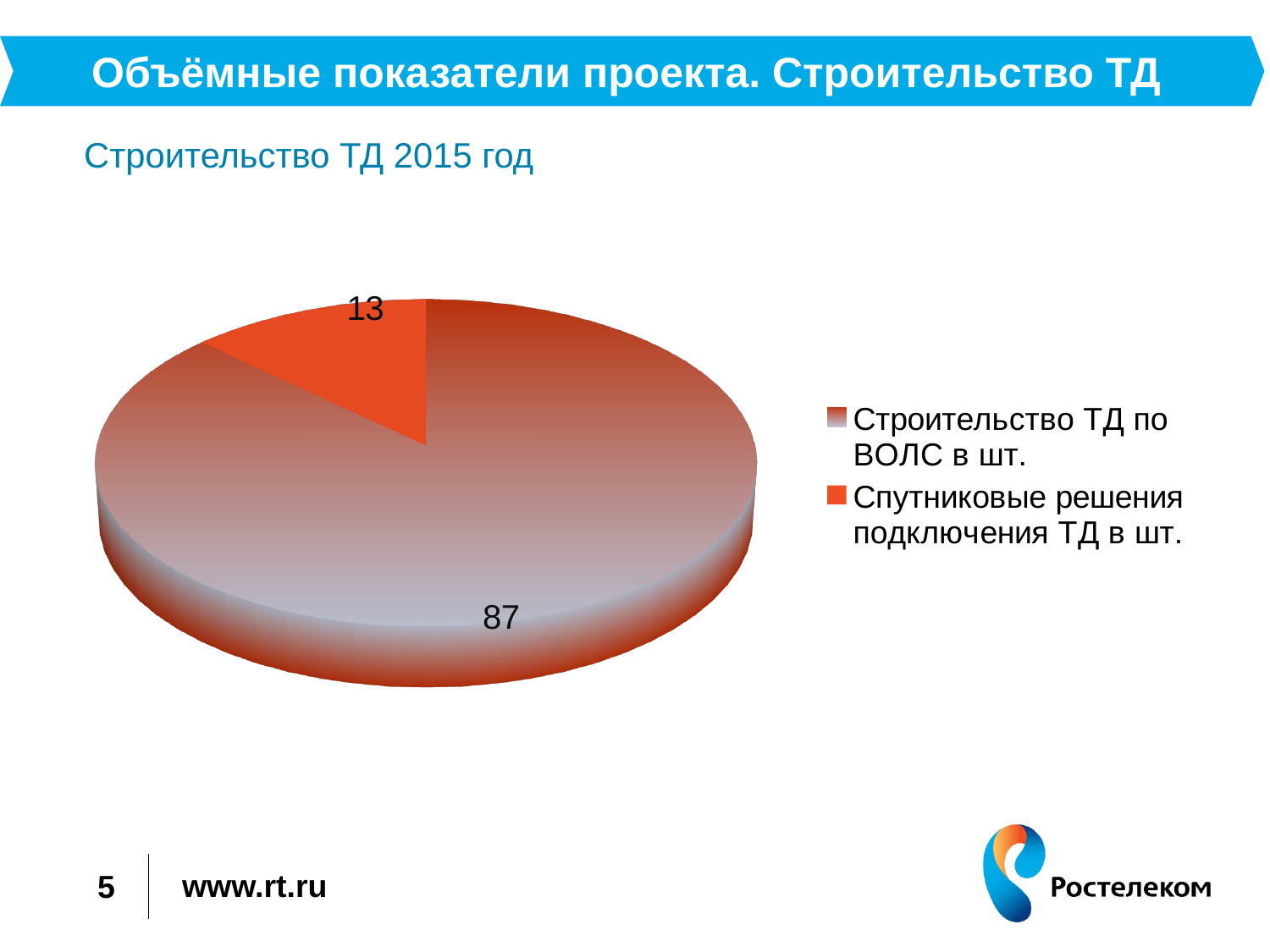
Which category has the smallest slice of the pie? Спутниковые решения подключения ТД в шт. What share of the pie does "Спутниковые решения подключения ТД в шт." represent? 13% What is the total of the two values shown on the pie chart? 100 What is the value for "Строительство ТД по ВОЛС в шт."? 87 How many entries does the legend list? 2 Which is larger: the value for "Строительство ТД по ВОЛС в шт." or for "Спутниковые решения подключения ТД в шт."? Строительство ТД по ВОЛС в шт. What is the difference between the values for "Строительство ТД по ВОЛС в шт." and "Спутниковые решения подключения ТД в шт."? 74 What is the title of the chart? Строительство ТД 2015 год What kind of chart is shown on the slide? Pie chart How many slices does the pie chart have? 2 What is the value for "Спутниковые решения подключения ТД в шт."? 13 Which category has the largest slice of the pie? Строительство ТД по ВОЛС в шт.